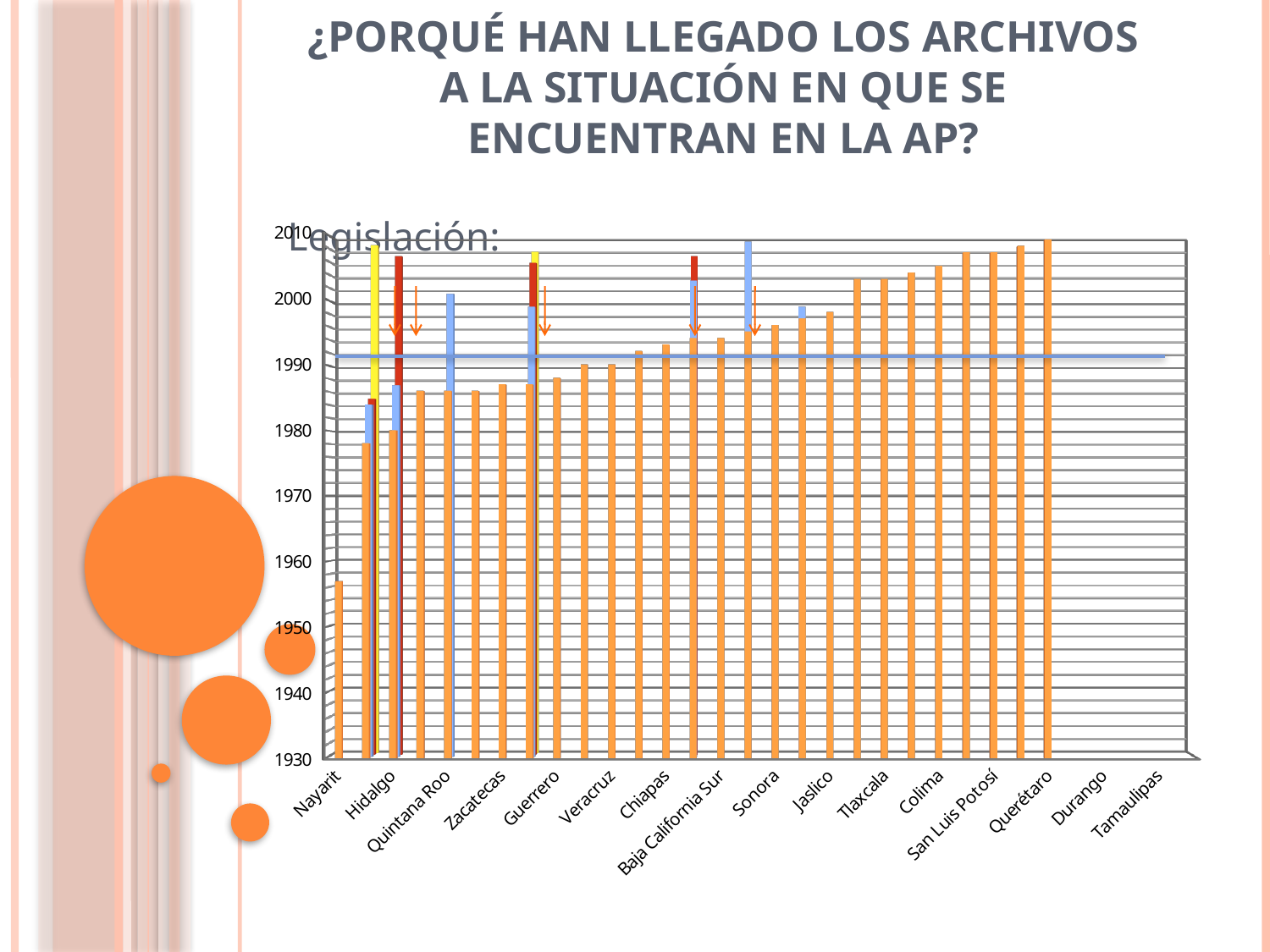
What is the lowest year shown on the vertical axis? 1930 Which category is labeled first on the x axis? Nayarit What kind of chart is shown on the slide? bar chart Is the value for Nayarit greater or less than 1950? greater What is the title shown above the chart? Legislación: Which is larger, the value for Nayarit or the value for Querétaro? Querétaro Is the value for Nayarit greater or less than 1960? less Which category has the lowest bar in the chart? Nayarit Do the bar values generally rise or fall from left to right along the x axis? rise How many state names are labeled on the x axis? 16